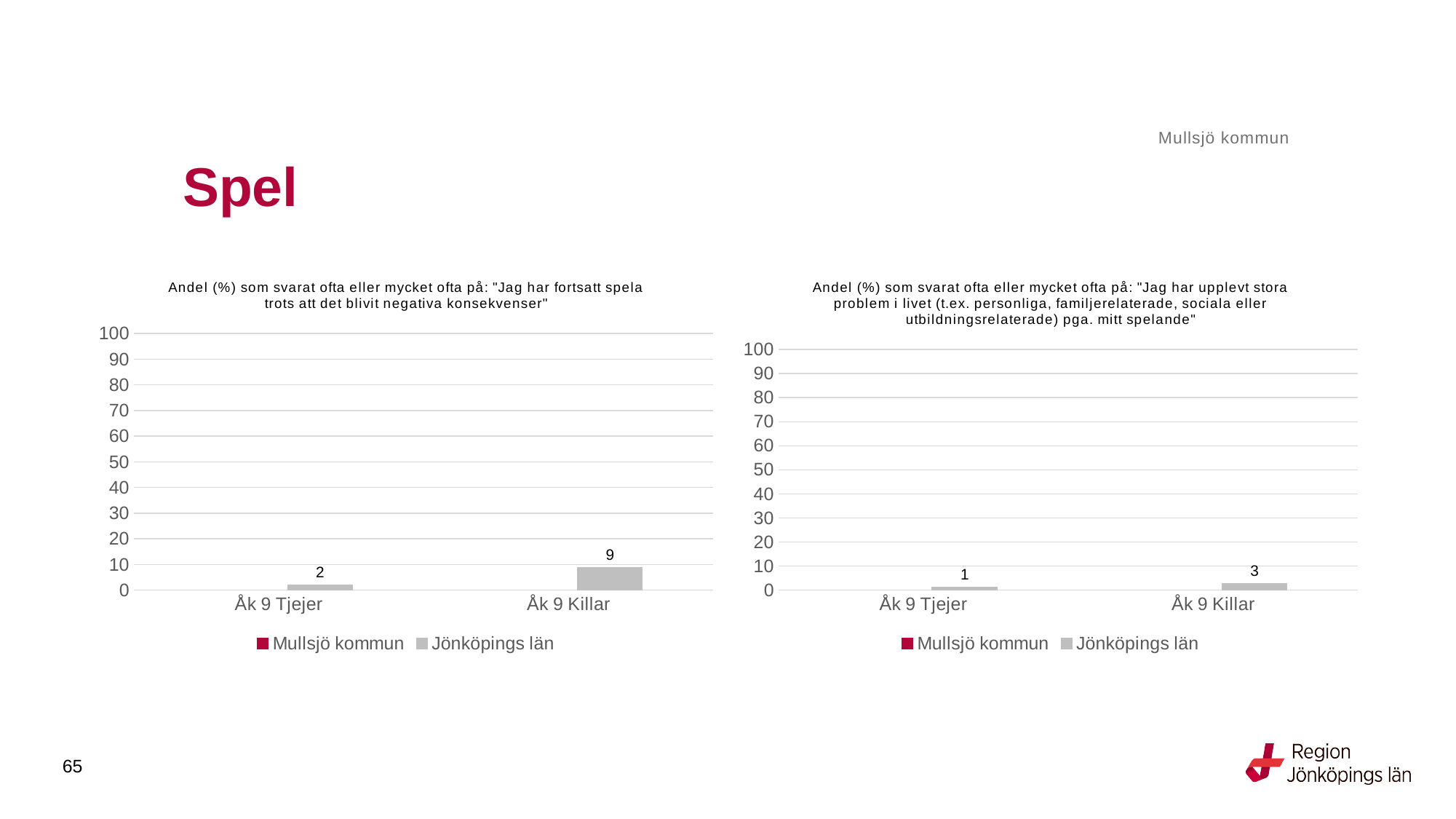
How many categories are shown on the x axis of the right chart? 2 In the right chart, what is the value for Jönköpings län for Åk 9 Killar? 3 In the left chart, what is the value for Jönköpings län for Åk 9 Tjejer? 2 In the left chart, which category has the higher Jönköpings län value, Åk 9 Tjejer or Åk 9 Killar? Åk 9 Killar In the left chart, what is the difference between the Jönköpings län values for Åk 9 Killar and Åk 9 Tjejer? 7 In the left chart, what is the value for Jönköpings län for Åk 9 Killar? 9 In the left chart, is the Jönköpings län value for Åk 9 Killar greater or less than 10? less What kind of chart is the right chart? Bar chart In the right chart, which category has the lowest Jönköpings län value? Åk 9 Tjejer In the right chart, what is the value for Jönköpings län for Åk 9 Tjejer? 1 In the right chart, what is the difference between the Jönköpings län values for Åk 9 Killar and Åk 9 Tjejer? 2 How many series does the legend of the left chart list? 2